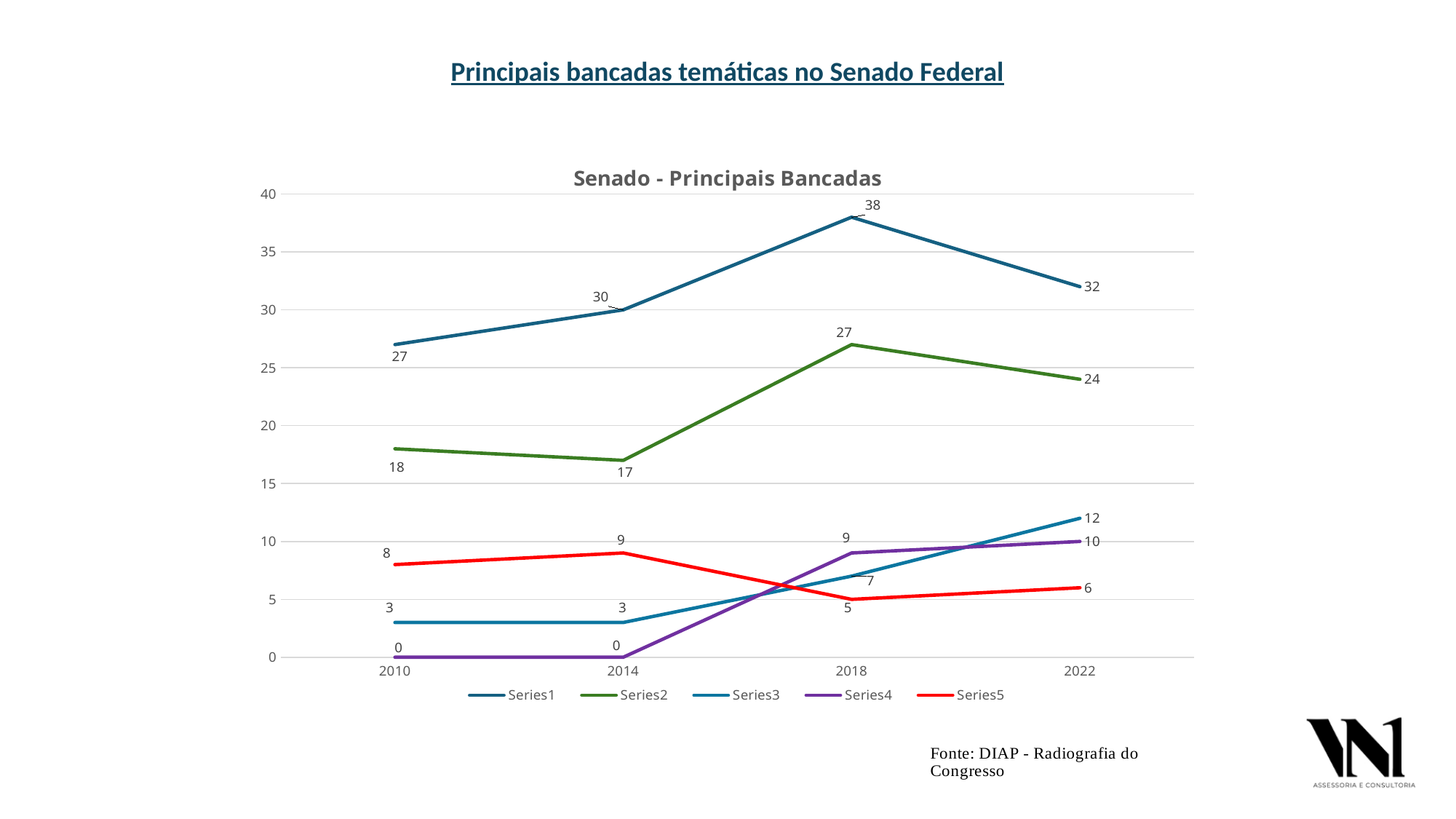
In which year does Series5 have its lowest value? 2018 Which is larger in 2022, Series3 or Series4? Series3 What is the value of Series2 in 2014? 17 What type of chart is shown on the slide? line chart Does Series3 rise or fall from 2014 to 2022? rise What is the value of Series4 in 2010? 0 What is the value of Series5 in 2022? 6 What is the difference between Series1 and Series2 in 2022? 8 What is the value of Series1 in 2018? 38 How many series does the legend list? 5 In which year does Series1 reach its highest value? 2018 How many years are shown on the x axis? 4